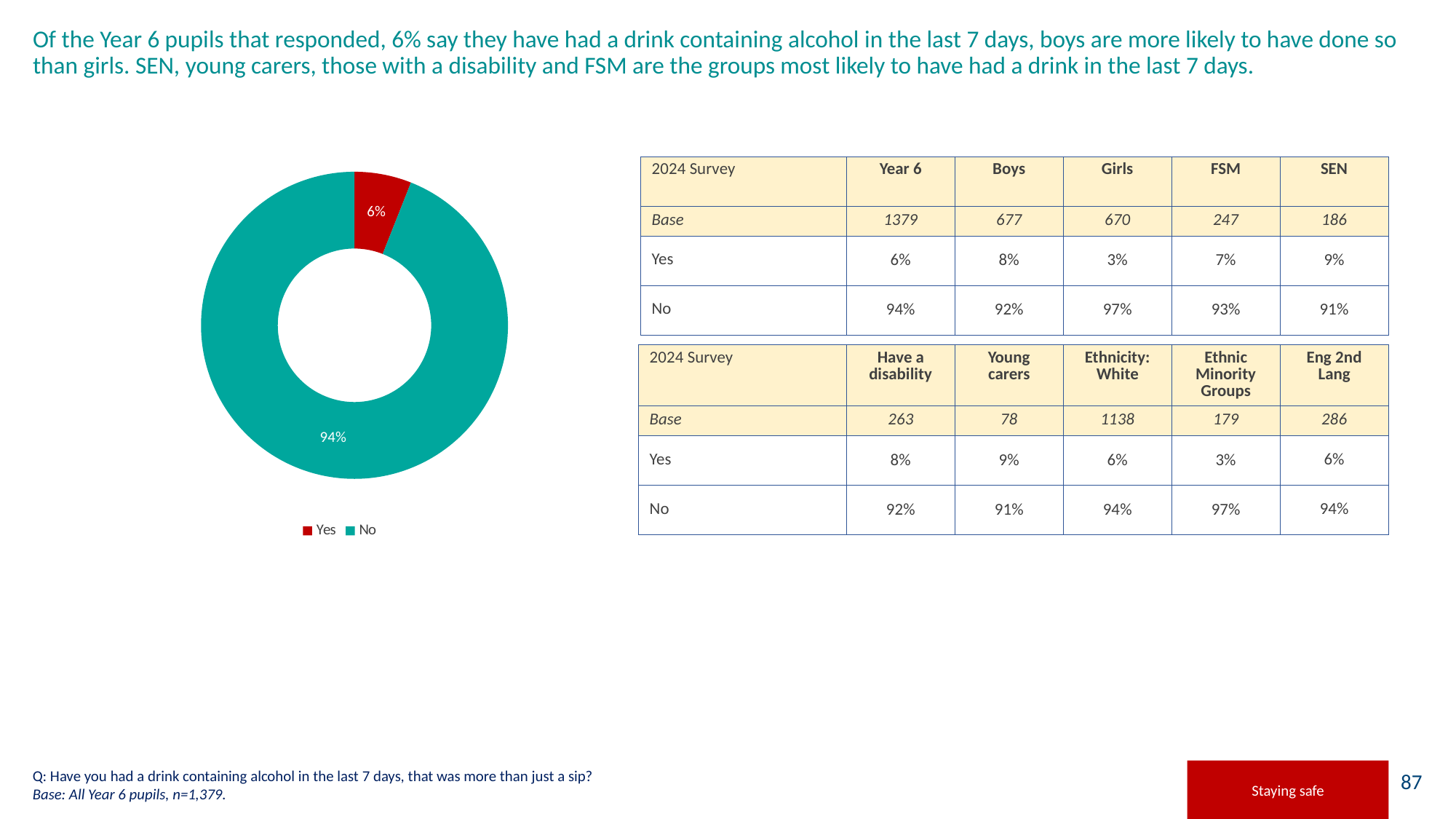
What kind of chart is shown on the slide? Doughnut chart Which slice of the doughnut chart is the largest? No What share of the doughnut chart does the 'Yes' slice represent? 6% How many entries does the legend of the doughnut chart list? 2 Which slice of the doughnut chart is the smallest? Yes What percentage of the doughnut chart is labelled 'Yes'? 6% What colour is the 'No' slice in the doughnut chart? Teal What percentage of the doughnut chart is labelled 'No'? 94% How many slices does the doughnut chart have? 2 What colour is the 'Yes' slice in the doughnut chart? Red What is the difference in percentage points between the 'No' and 'Yes' slices of the doughnut chart? 88 Which is larger in the doughnut chart, the 'Yes' slice or the 'No' slice? No